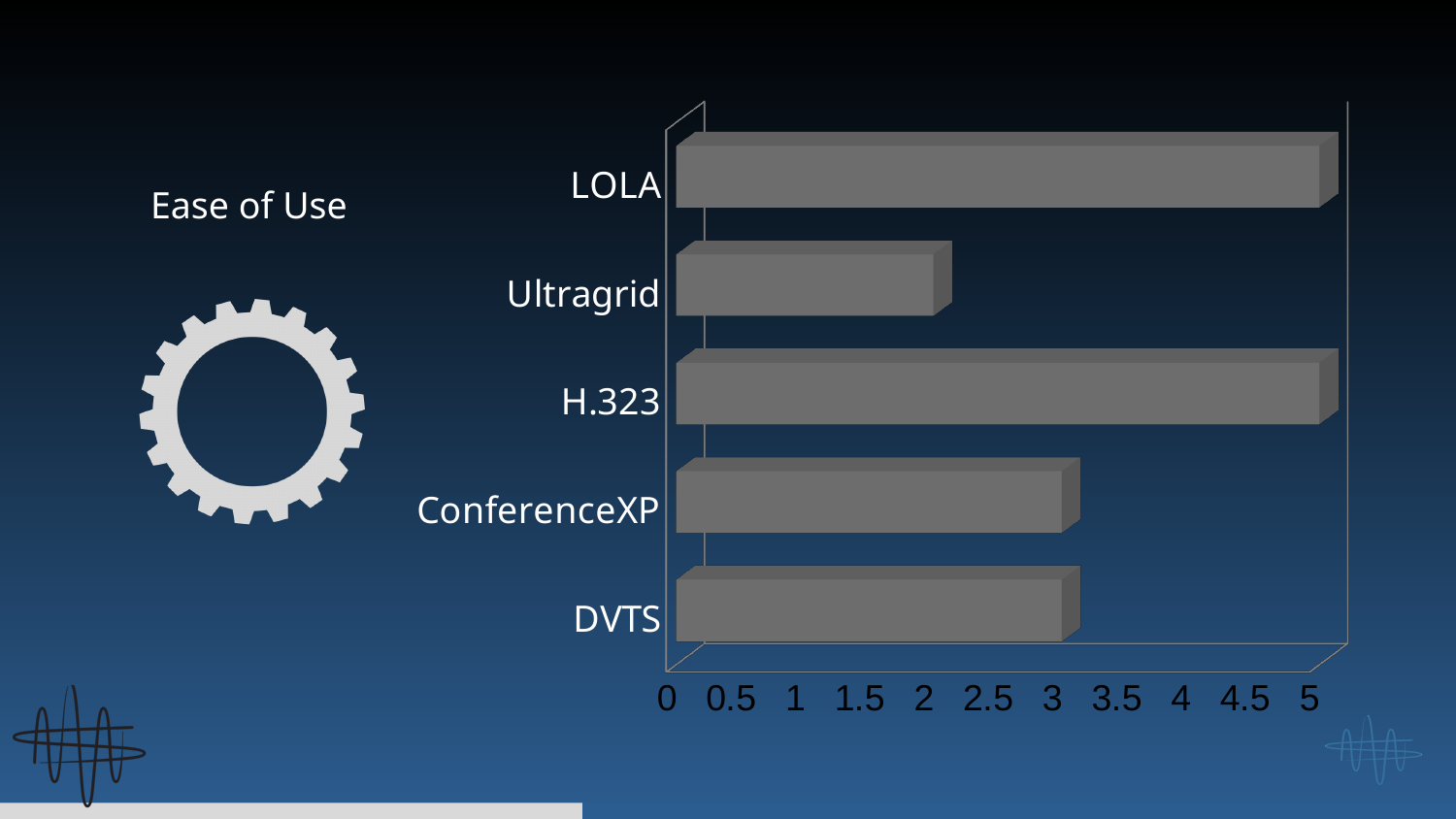
How many categories (tools) are plotted in the chart? 5 Which has a larger value, LOLA or Ultragrid? LOLA Which has a larger value, Ultragrid or DVTS? DVTS Is the value for LOLA greater or less than 4? greater What is the title shown next to the chart? Ease of Use Is the value for ConferenceXP greater or less than 4? less Is the value for Ultragrid greater or less than 3? less Which category has the lowest value in the chart? Ultragrid What kind of chart is shown on the slide? bar chart